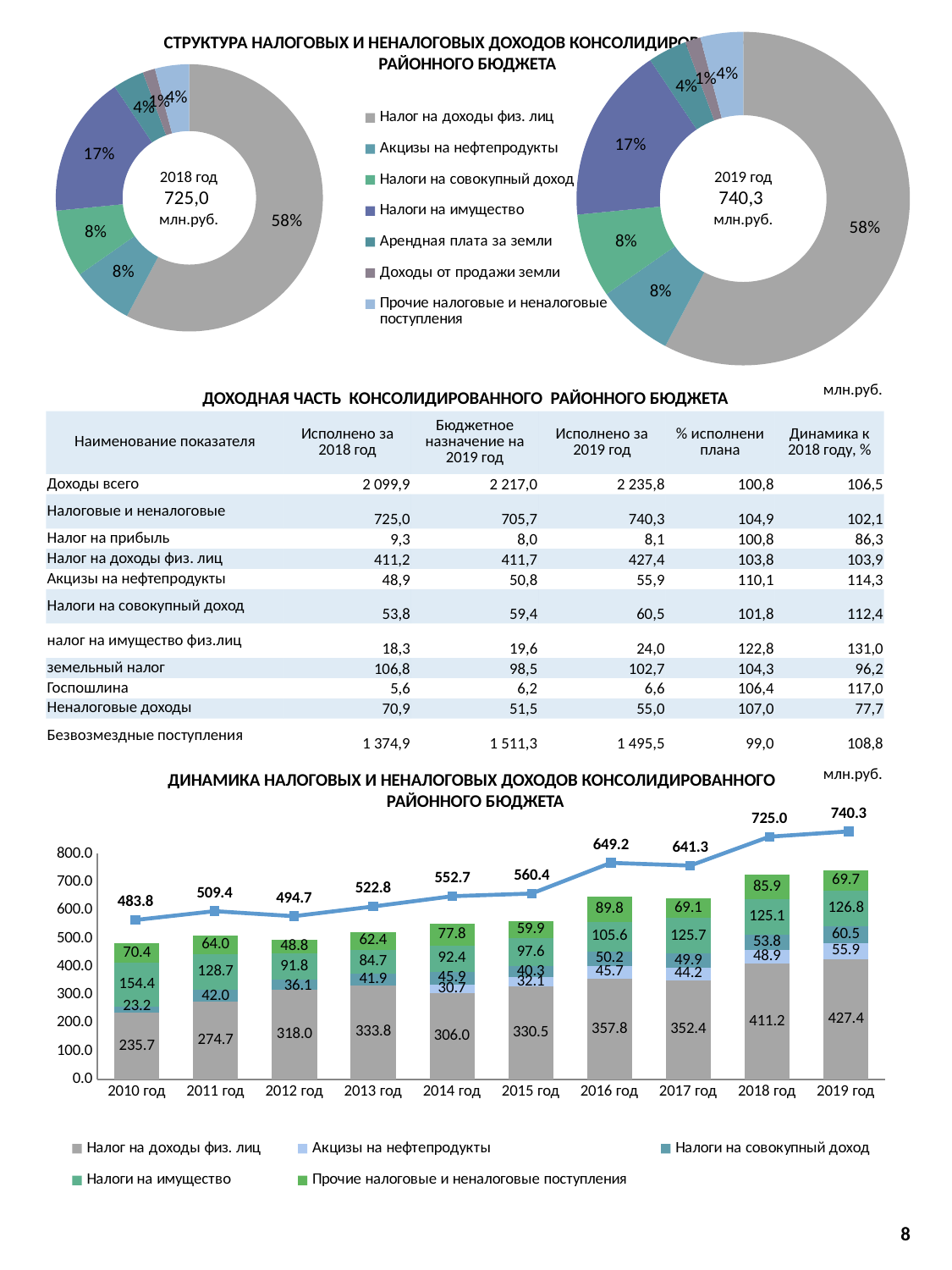
In the 2019 год donut chart, what share does Налоги на имущество have? 17% What total is shown in the centre of the 2018 год donut chart? 725,0 млн.руб. What kind of chart is the chart at the top left of the slide (2018 год)? pie (donut) chart In the bottom chart, what is the difference between the line values for 2019 год and 2018 год? 15.3 In the bottom chart, which year has the highest line value? 2019 год In the bottom chart, which year has the lowest line value? 2010 год In the bottom chart, what is the line value labelled for 2016 год? 649.2 In the 2018 год donut chart, what share does Налог на доходы физ. лиц have? 58% In the bottom chart, what is the value of Налоги на имущество for 2018 год? 125.1 In the bottom chart (ДИНАМИКА НАЛОГОВЫХ И НЕНАЛОГОВЫХ ДОХОДОВ), how many series does the legend list? 5 In the bottom chart (ДИНАМИКА НАЛОГОВЫХ И НЕНАЛОГОВЫХ ДОХОДОВ), how many years are shown on the x axis? 10 In the bottom chart, what is the value of Налог на доходы физ. лиц for 2019 год? 427.4